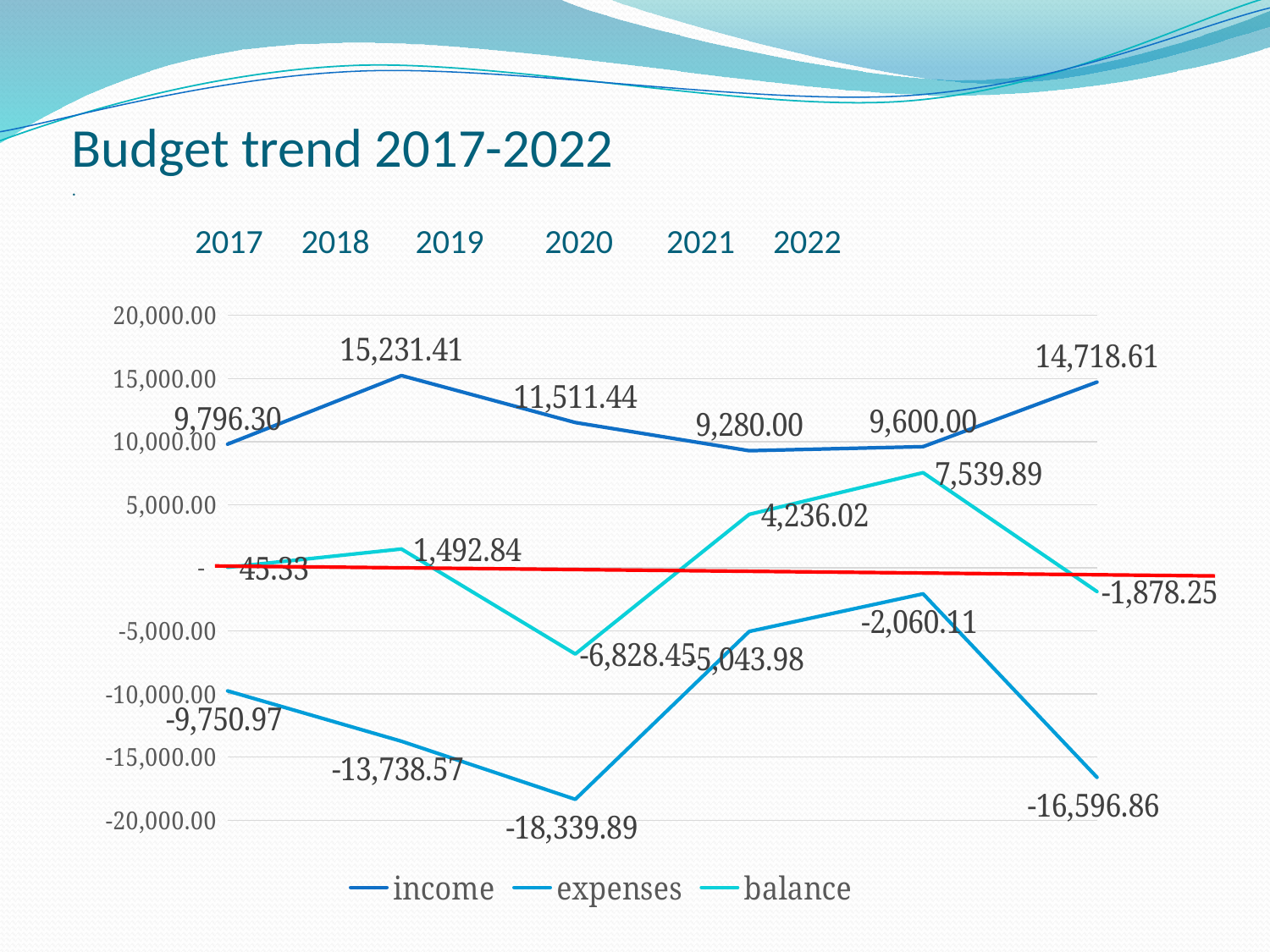
In which year is the balance lowest? 2019 What is the difference between income in 2018 and income in 2020? 5,951.41 What is the expenses value for 2019? -18,339.89 How many series does the legend list? 3 How many years are plotted on the x axis? 6 What is the income value for 2018? 15,231.41 In which year is income highest? 2018 What is the balance value for 2021? 7,539.89 What is the income value for 2022? 14,718.61 What is the title of the chart? Budget trend 2017-2022 Which is larger, the balance in 2020 or the balance in 2021? 2021 What type of chart is shown on the slide? line chart